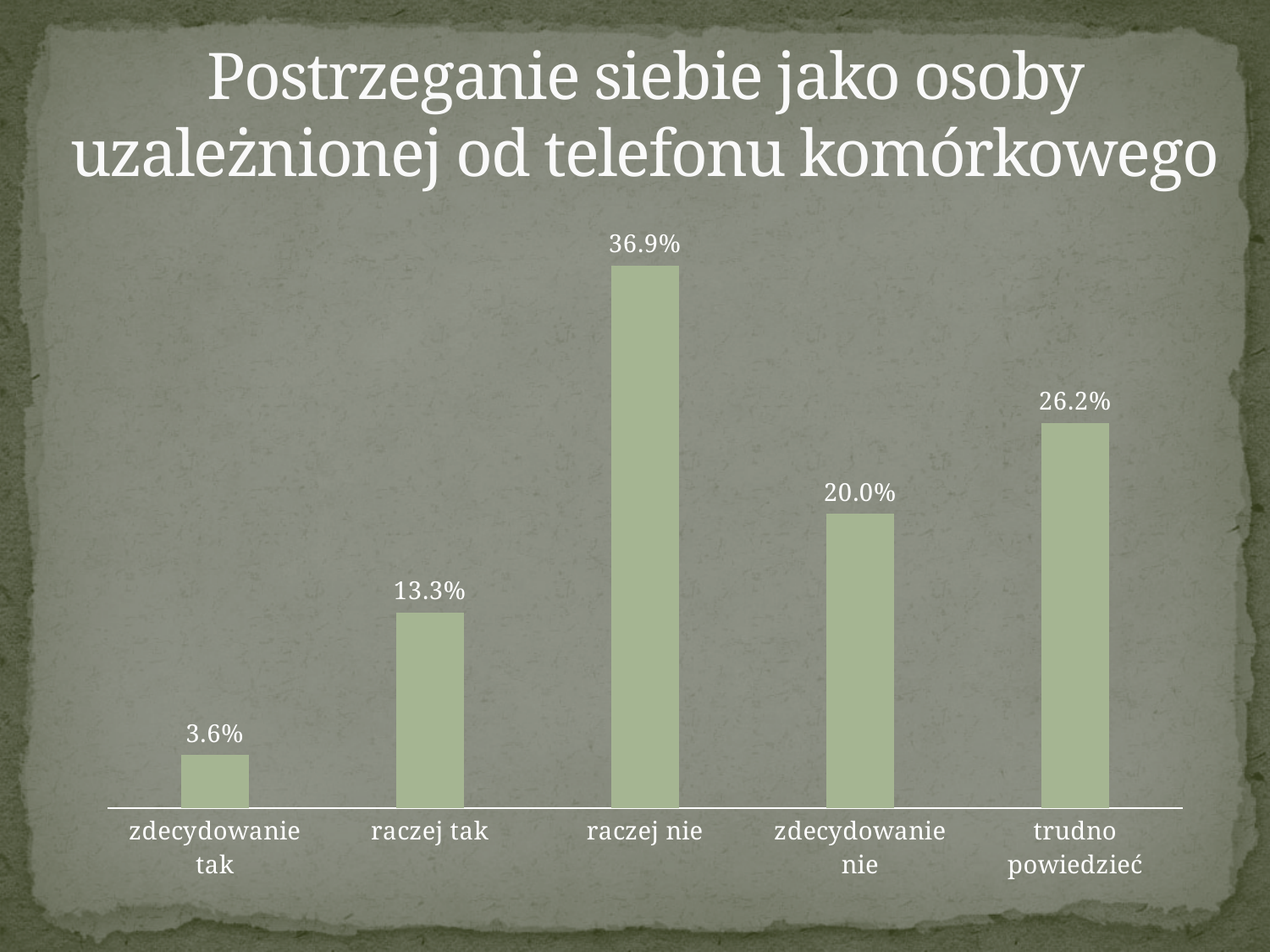
What is the value for "zdecydowanie nie"? 20.0% Which category has the highest value? raczej nie What is the value for "trudno powiedzieć"? 26.2% Which is larger, the value for "trudno powiedzieć" or the value for "zdecydowanie nie"? trudno powiedzieć What kind of chart is shown on the slide? bar chart What is the difference between the values for "raczej nie" and "zdecydowanie nie"? 16.9% What is the title of the slide? Postrzeganie siebie jako osoby uzależnionej od telefonu komórkowego How many categories are shown on the x axis? 5 What is the difference between the values for "raczej tak" and "zdecydowanie tak"? 9.7% Which category has the lowest value? zdecydowanie tak What is the value for "zdecydowanie tak"? 3.6% What is the value for "raczej nie"? 36.9%